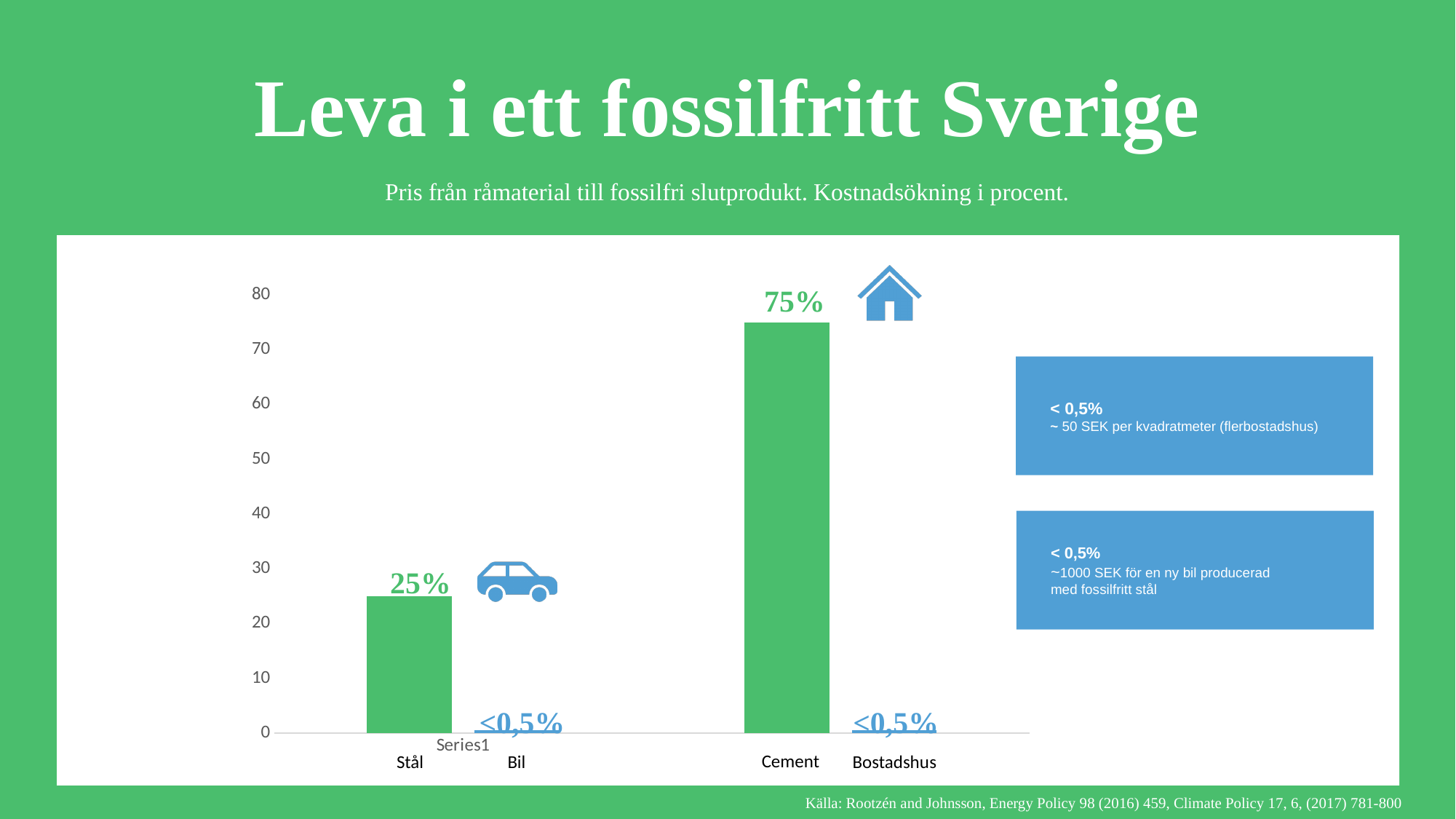
What value label is shown for Bil? ≤0,5% Is the value for Stål greater or less than 30? less How many categories are shown on the x axis of the chart? 4 What is the value shown for Cement? 75% Which is larger, the value for Stål or the value for Cement? Cement What is the value shown for Stål? 25% What is the difference between the values for Cement and Stål? 50% What is the title of the slide containing the chart? Leva i ett fossilfritt Sverige Is the value for Cement greater or less than 70? greater Which category has the highest value? Cement What kind of chart is shown on the slide? bar chart What value label is shown for Bostadshus? ≤0,5%